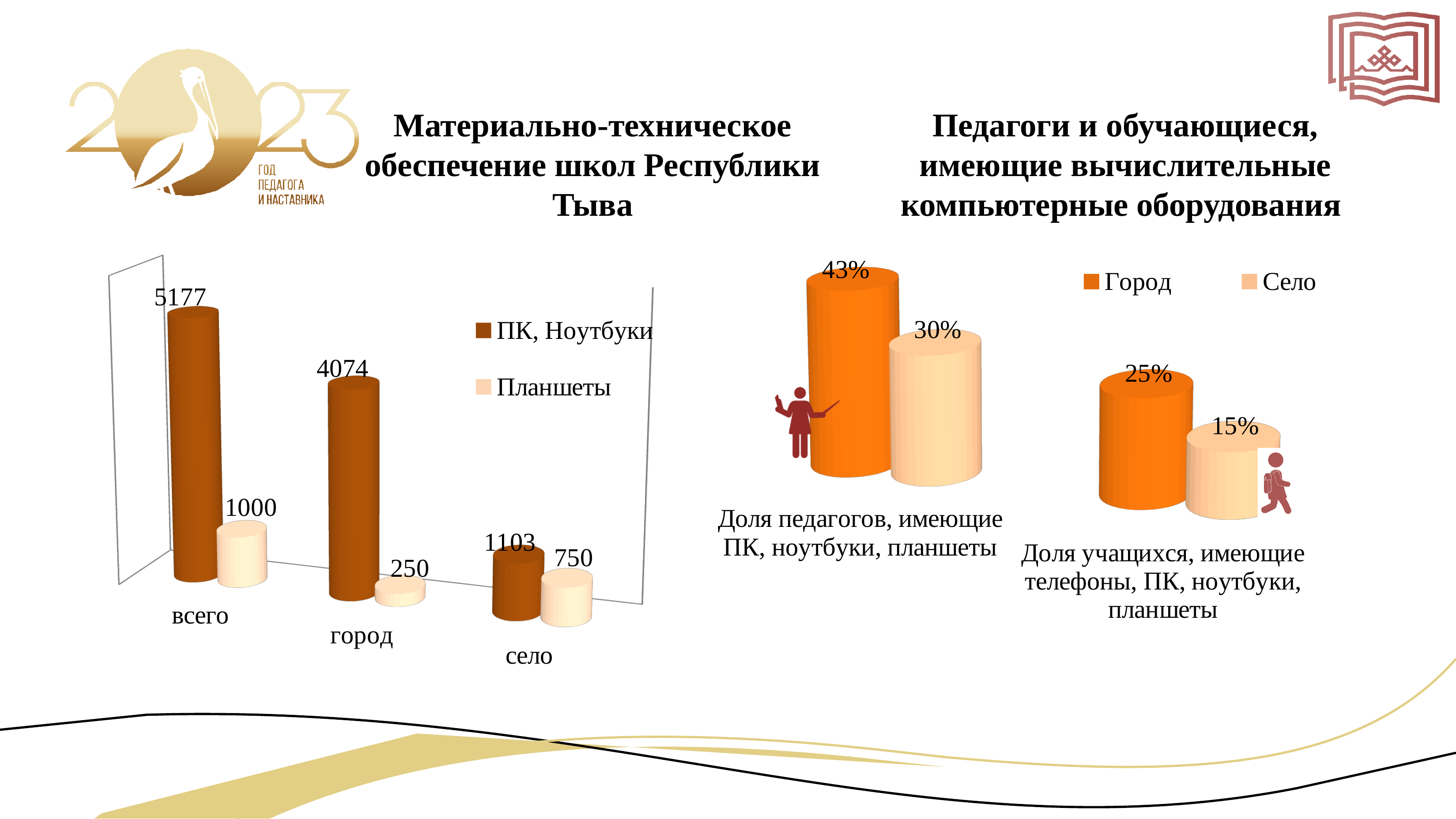
In the right chart (Педагоги и обучающиеся, имеющие вычислительные компьютерные оборудования), what is the value for Город among педагоги (Доля педагогов, имеющие ПК, ноутбуки, планшеты)? 43% In the right chart (Педагоги и обучающиеся, имеющие вычислительные компьютерные оборудования), what is the difference between Город and Село for педагоги? 13% In the left chart (Материально-техническое обеспечение школ Республики Тыва), what is the value for ПК, Ноутбуки in the category село? 1103 In the left chart (Материально-техническое обеспечение школ Республики Тыва), which is larger: Планшеты for всего or Планшеты for село? всего What kind of chart is the right chart (Педагоги и обучающиеся, имеющие вычислительные компьютерные оборудования)? bar chart In the left chart (Материально-техническое обеспечение школ Республики Тыва), which category has the lowest value for ПК, Ноутбуки? село In the right chart (Педагоги и обучающиеся, имеющие вычислительные компьютерные оборудования), what is the value for Село among учащиеся (Доля учащихся, имеющие телефоны, ПК, ноутбуки, планшеты)? 15% In the left chart (Материально-техническое обеспечение школ Республики Тыва), what is the value for ПК, Ноутбуки in the category всего? 5177 In the left chart (Материально-техническое обеспечение школ Республики Тыва), how many categories are shown on the x axis? 3 In the left chart (Материально-техническое обеспечение школ Республики Тыва), what is the value for Планшеты in the category город? 250 In the left chart (Материально-техническое обеспечение школ Республики Тыва), what is the difference between ПК, Ноутбуки and Планшеты in the category село? 353 In the left chart (Материально-техническое обеспечение школ Республики Тыва), how many series does the legend list? 2